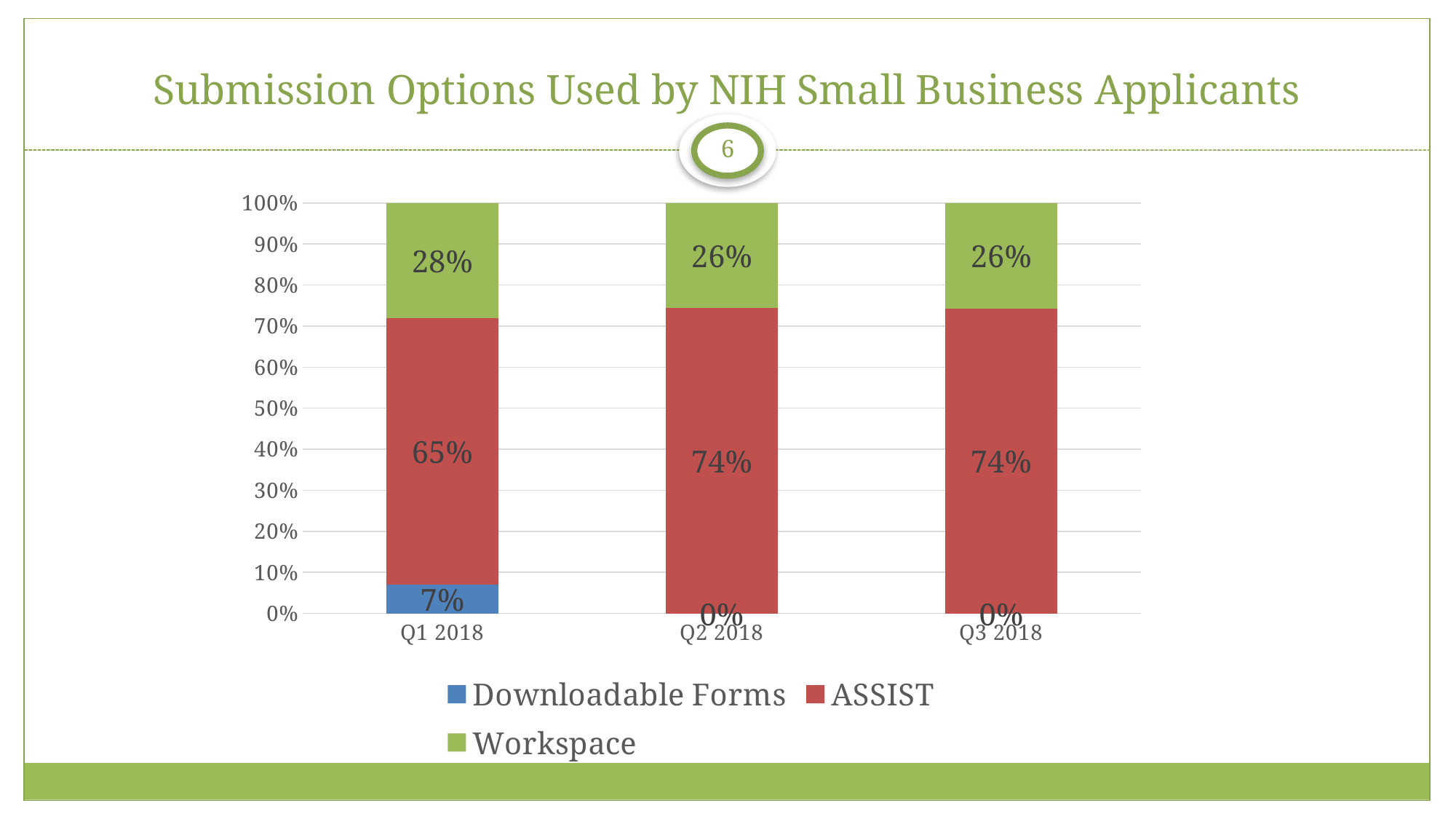
What percentage of Q3 2018 submissions used ASSIST? 74% In which quarter was the Workspace share highest? Q1 2018 What kind of chart is shown on the slide? Stacked bar chart What is the title of the chart? Submission Options Used by NIH Small Business Applicants What percentage of Q2 2018 submissions used Workspace? 26% What percentage of Q1 2018 submissions used ASSIST? 65% What is the difference between the ASSIST share in Q2 2018 and in Q1 2018? 9% Which is larger in Q1 2018: the ASSIST share or the Workspace share? ASSIST How many series does the legend list? 3 How many quarters are shown on the x axis? 3 In which quarter was the ASSIST share lowest? Q1 2018 What percentage of Q1 2018 submissions used Downloadable Forms? 7%